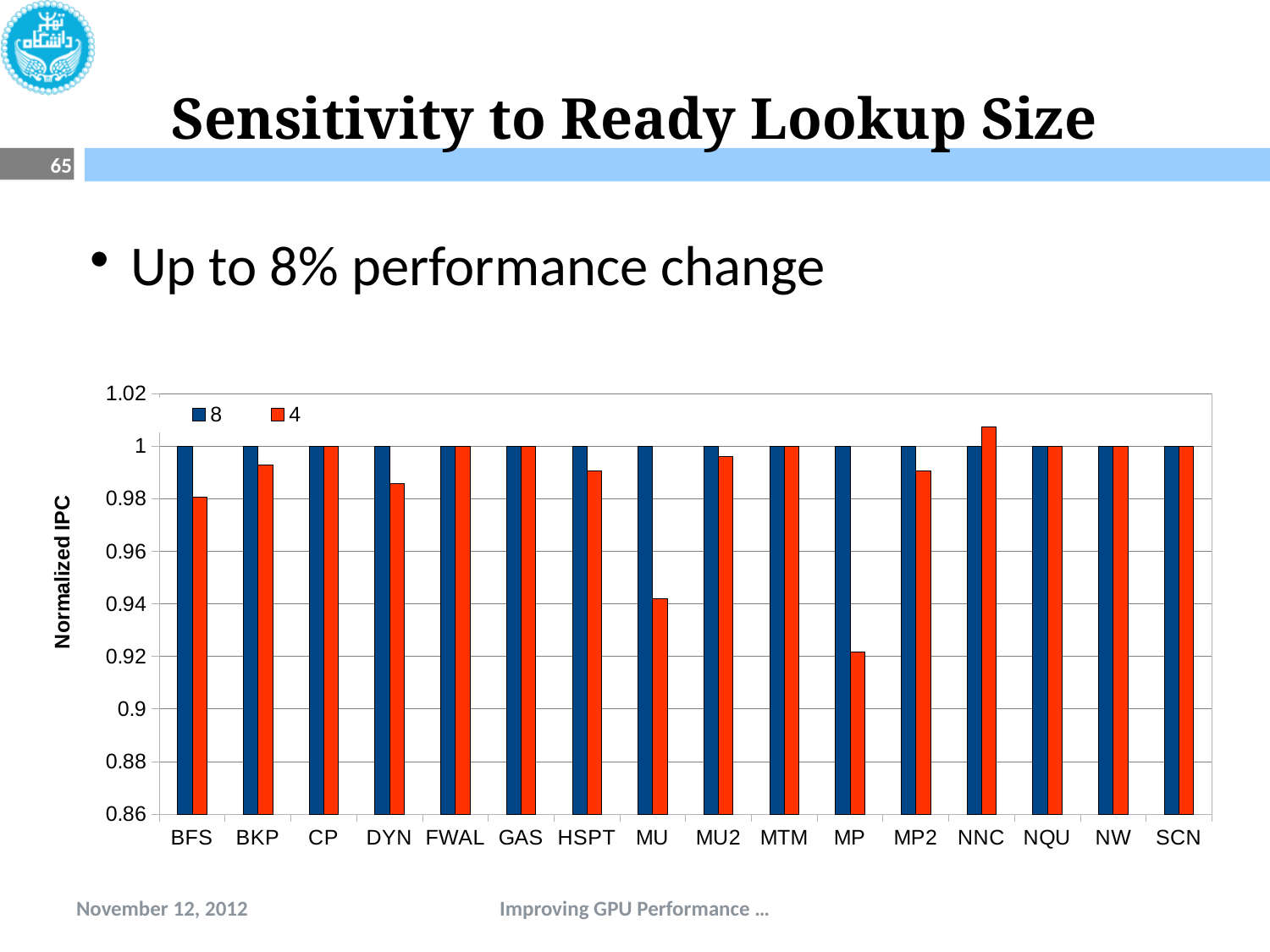
How many benchmark categories are shown along the x axis of the chart? 16 What is the title of the chart's y axis? Normalized IPC What is the Normalized IPC value for series 8 at BFS? 1 Which category has the highest Normalized IPC for series 4? NNC What kind of chart is shown on the slide? bar chart What are the two entries in the chart's legend? 8 and 4 Which category has the lowest Normalized IPC for series 4? MP For series 4, which is larger: the value for MU or the value for MP? MU Is the series 4 value for MP greater or less than 0.94? less Is the series 4 value for MU greater or less than 0.92? greater How many series does the chart's legend list? 2 Is the series 4 value for NNC greater or less than 1? greater